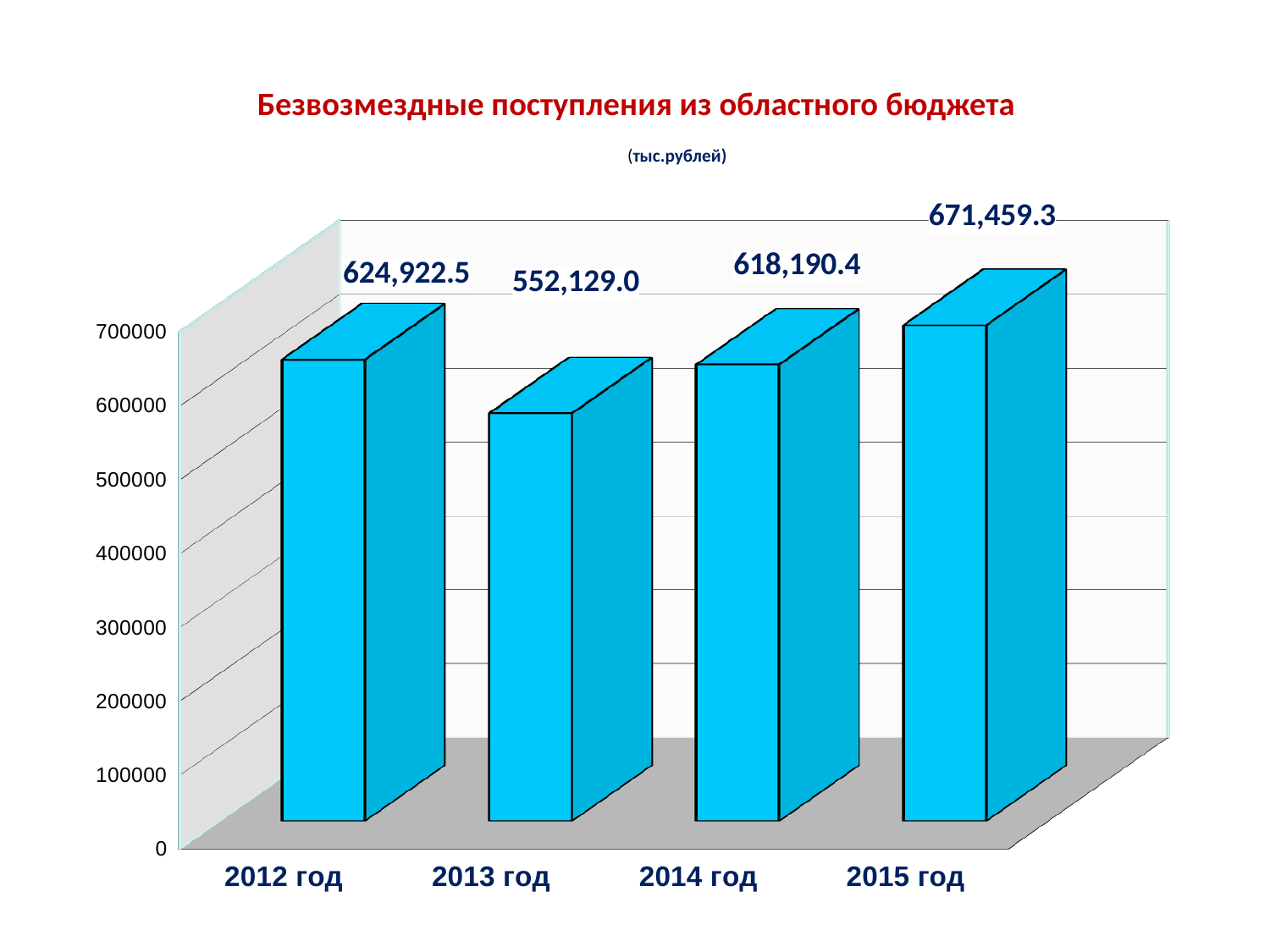
What is the difference between the values for 2015 год and 2013 год? 119,330.3 What is the difference between the values for 2012 год and 2014 год? 6,732.1 Is the value for 2013 год greater or less than 600000? less What kind of chart is shown on the slide? bar chart What is the value for 2012 год? 624,922.5 Do the values rise or fall from 2013 год to 2015 год? rise What is the value for 2013 год? 552,129.0 Which year has the lowest value? 2013 год Which is larger, the value for 2012 год or the value for 2014 год? 2012 год How many years are shown on the x axis? 4 Which year has the highest value? 2015 год What is the value for 2015 год? 671,459.3